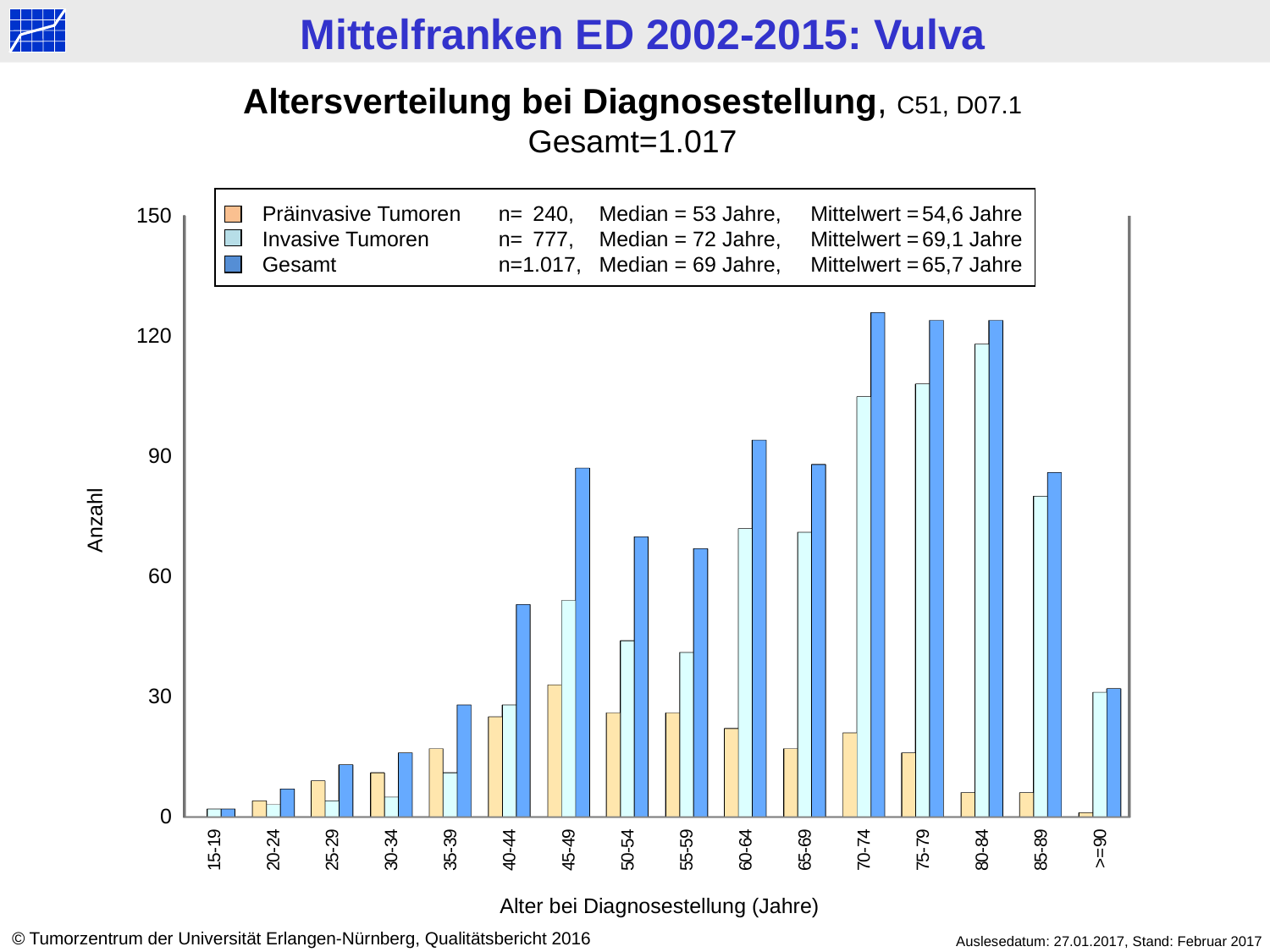
How many series does the legend list? 3 Is the Invasive Tumoren value for the 15-19 age group greater or less than 30? less Is the Gesamt value for the 70-74 age group greater or less than 120? greater According to the legend, what is the median age for Invasive Tumoren? 72 Jahre Is the Gesamt value for the 60-64 age group greater or less than 60? greater Which age group has the highest value for Präinvasive Tumoren? 45-49 In the 30-34 age group, which is larger: Präinvasive Tumoren or Invasive Tumoren? Präinvasive Tumoren Which age group has the highest value for Invasive Tumoren? 80-84 How many age categories are shown on the x axis? 16 In the 70-74 age group, which is larger: Präinvasive Tumoren or Invasive Tumoren? Invasive Tumoren What kind of chart is shown on the slide? bar chart